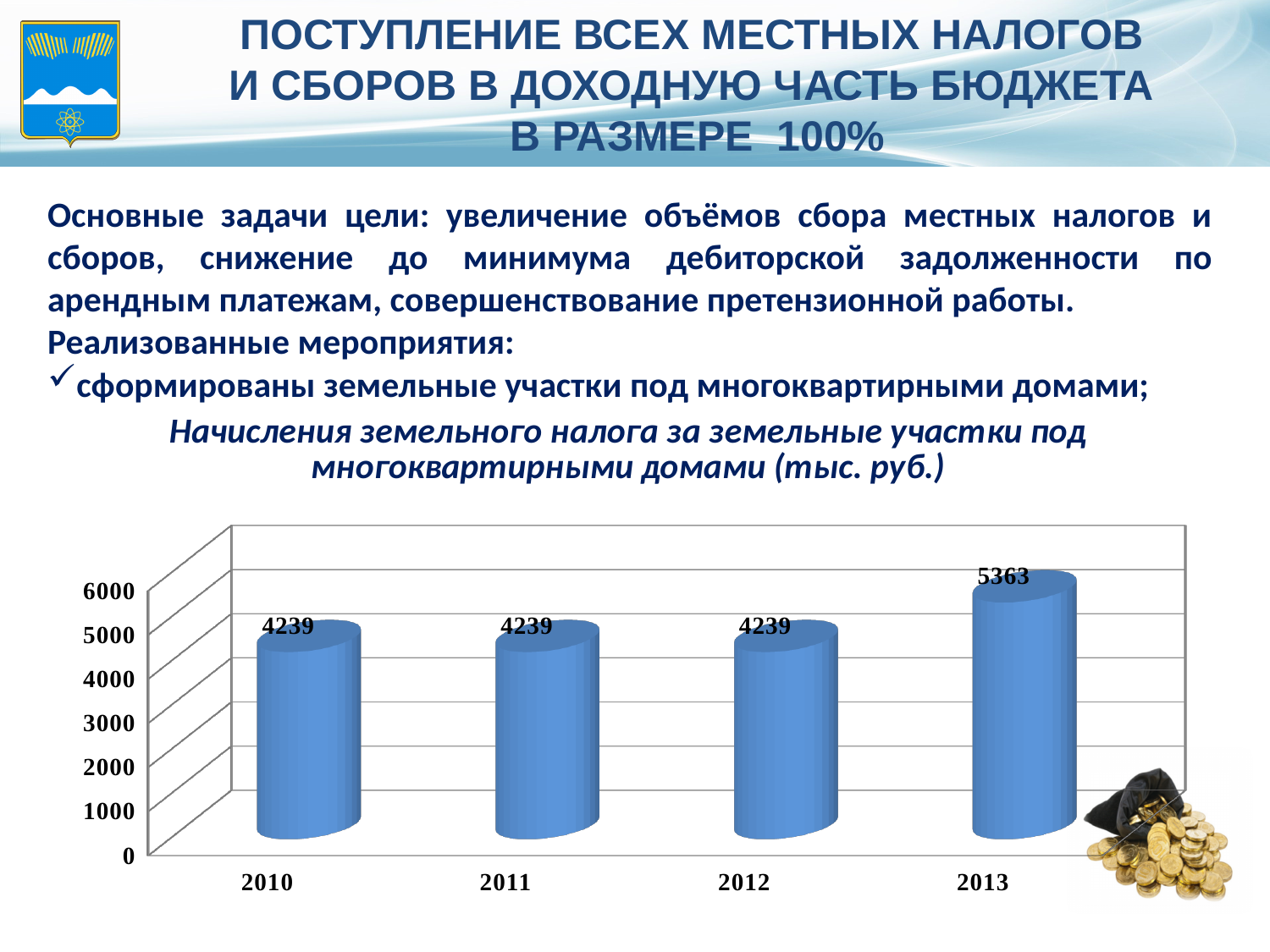
What is the value for 2012? 4239 What is the difference between the values for 2013 and 2012? 1124 What kind of chart is shown? bar chart Is the value for 2013 greater or less than 5000? greater What is the value for 2010? 4239 How many years are shown on the x axis? 4 Is the value for 2010 greater or less than 5000? less Which is larger, the value for 2011 or the value for 2013? 2013 Do the values for 2010, 2011 and 2012 differ from each other? No, all are 4239 What is the value for 2013? 5363 What unit is given in the chart title? тыс. руб. Which year has the highest value? 2013